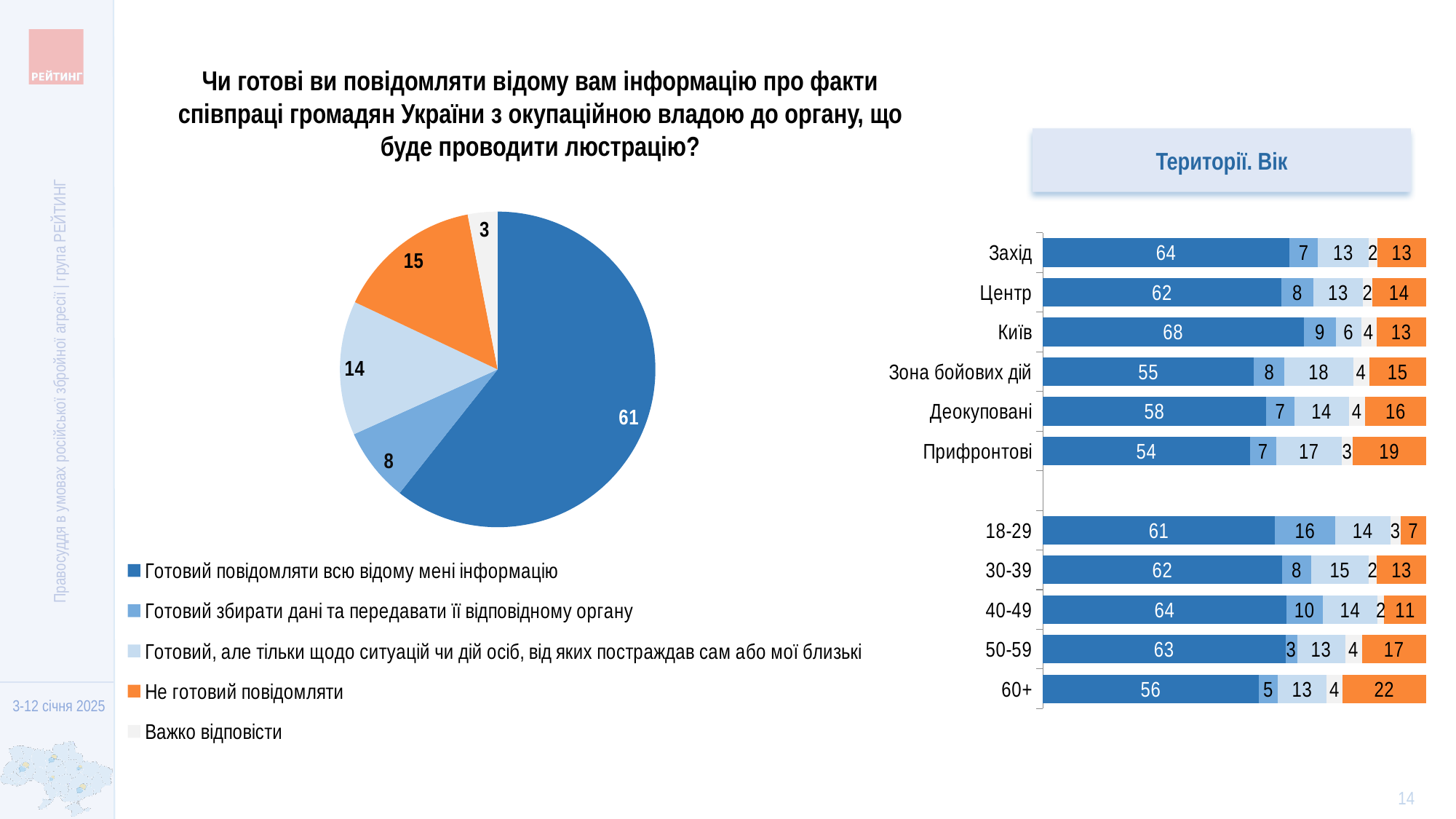
In the pie chart on the left, what is the value of the "Не готовий повідомляти" slice? 15 In the "Території. Вік" chart on the right, which territory has the highest dark blue value? Київ How many categories (territories and age groups combined) are shown in the "Території. Вік" chart on the right? 11 In the "Території. Вік" chart on the right, what is the orange ("Не готовий повідомляти") value for 60+? 22 In the "Території. Вік" chart on the right, which has a larger orange value: Деокуповані or Центр? Деокуповані In the "Території. Вік" chart on the right, what is the dark blue value for Київ? 68 In the "Території. Вік" chart on the right, what is the difference between the dark blue values for Захід and Прифронтові? 10 In the pie chart on the left, what percentage of respondents chose "Готовий повідомляти всю відому мені інформацію"? 61 In the pie chart on the left, which response has the smallest slice? Важко відповісти How many entries does the legend below the pie chart list? 5 In the "Території. Вік" chart on the right, which age group has the lowest orange value? 18-29 What type of chart is shown on the left side of the slide? Pie chart